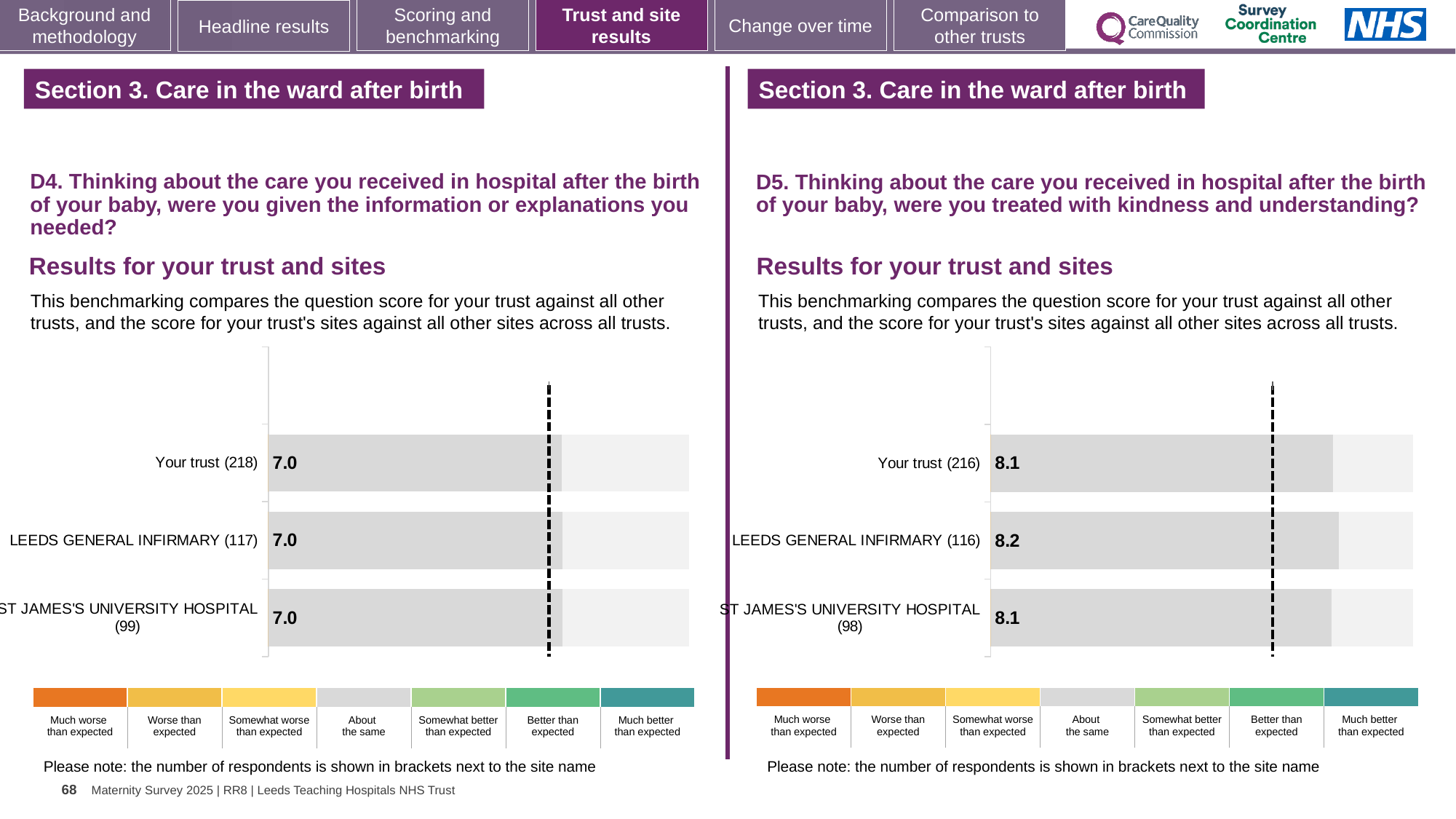
In the D5 chart on the right, what is the score for Your trust (216)? 8.1 In the D4 chart on the left, what is the score for Your trust (218)? 7.0 In the D5 chart on the right, what is the score for ST JAMES'S UNIVERSITY HOSPITAL (98)? 8.1 In the D5 chart on the right, which site has the highest score? LEEDS GENERAL INFIRMARY (116) In the D4 chart on the left, what is the score for ST JAMES'S UNIVERSITY HOSPITAL (99)? 7.0 In the D5 chart on the right, what is the difference between the scores for LEEDS GENERAL INFIRMARY (116) and ST JAMES'S UNIVERSITY HOSPITAL (98)? 0.1 In the D5 chart on the right, how many bars are plotted? 3 In the D5 chart on the right, what is the score for LEEDS GENERAL INFIRMARY (116)? 8.2 What type of chart is the D4 chart on the left? Bar chart In the D4 chart on the left, how many respondents are shown in brackets for Your trust? 218 In the D4 chart on the left, how many bars are plotted? 3 In the D4 chart on the left, what is the score for LEEDS GENERAL INFIRMARY (117)? 7.0